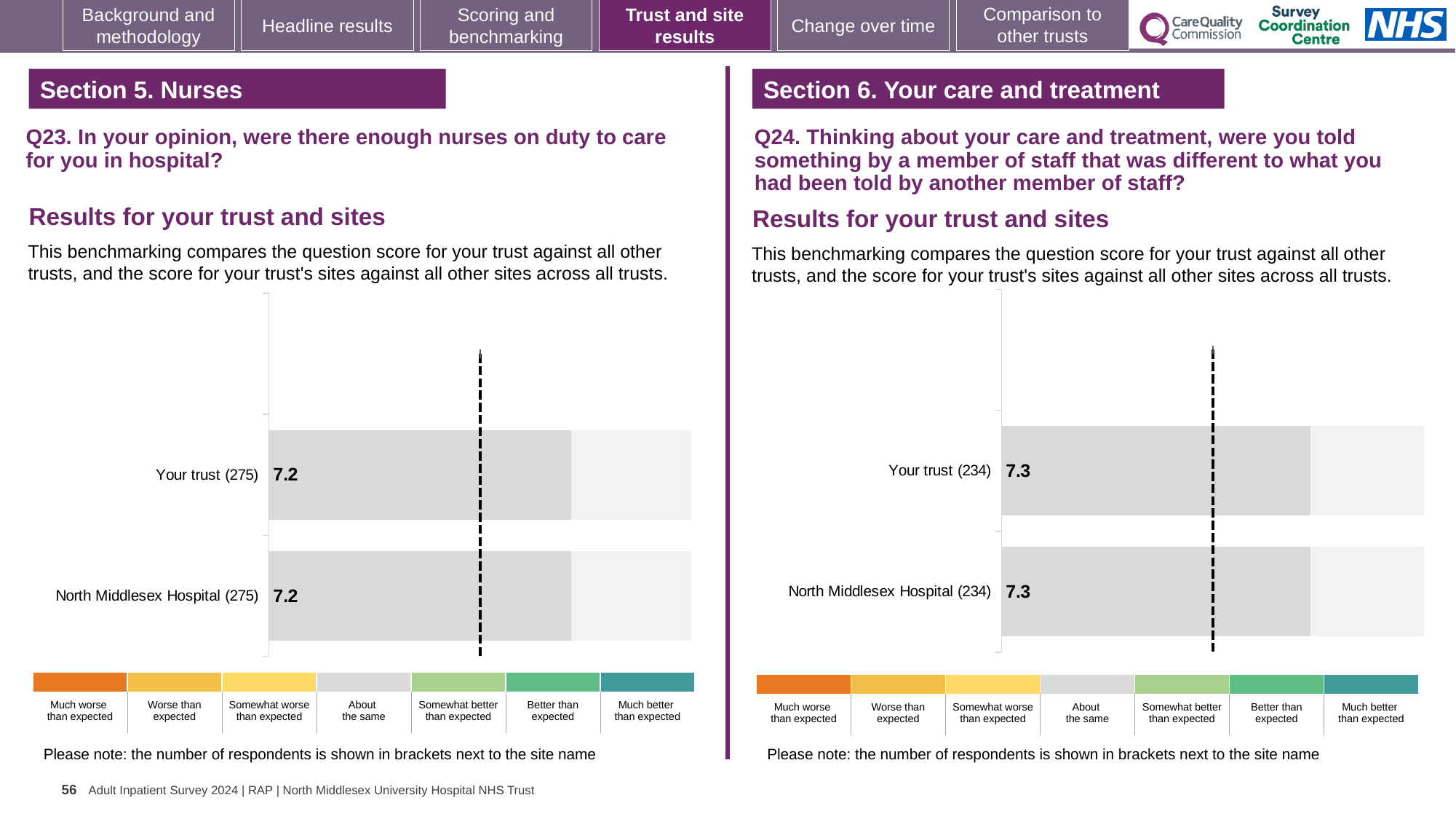
In the Q23 chart on the left, how many respondents are shown in brackets next to Your trust? 275 In the Q23 chart on the left, what is the score for North Middlesex Hospital? 7.2 Is the score for Your trust in the Q24 chart on the right larger or smaller than the score for Your trust in the Q23 chart on the left? Larger What kind of chart is used for the Q23 results on the left? Bar chart In the Q23 chart on the left, what is the score for Your trust? 7.2 In the Q24 chart on the right, what is the score for Your trust? 7.3 In the Q24 chart on the right, how many respondents are shown in brackets next to North Middlesex Hospital? 234 How many bars are plotted in the Q24 chart on the right? 2 In the Q23 chart on the left, what is the difference between the score for Your trust and the score for North Middlesex Hospital? 0 In the Q24 chart on the right, what is the score for North Middlesex Hospital? 7.3 How many bars are plotted in the Q23 chart on the left? 2 In the Q24 chart on the right, what is the difference between the score for Your trust and the score for North Middlesex Hospital? 0